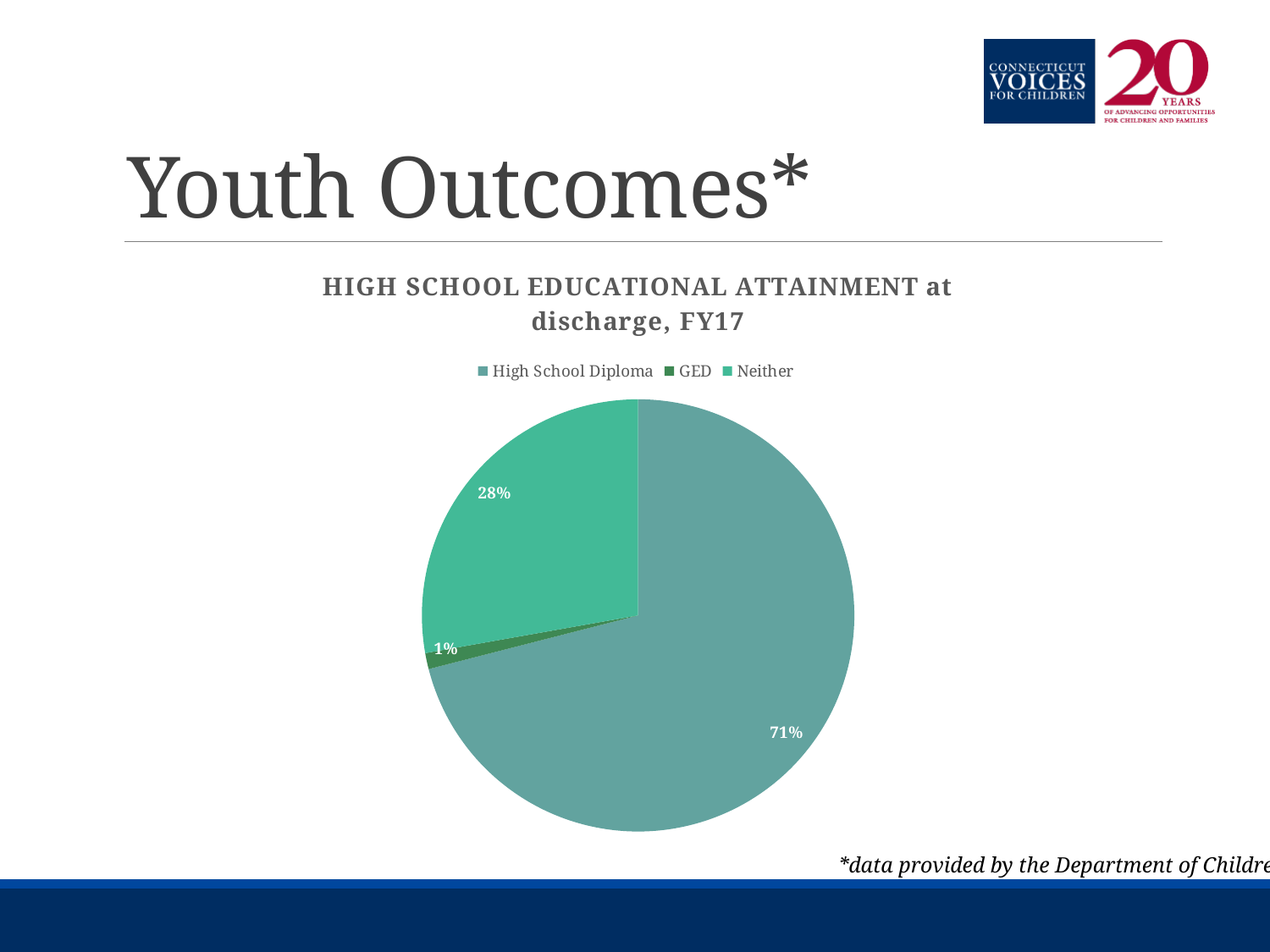
Which category has the smallest slice of the pie? GED Which is larger, the Neither slice or the GED slice? Neither Which category has the largest slice of the pie? High School Diploma What is the title of the chart? HIGH SCHOOL EDUCATIONAL ATTAINMENT at discharge, FY17 What share of the pie is labelled Neither? 28% What are the three legend entries of the chart? High School Diploma, GED, Neither What share of the pie is labelled GED? 1% What is the combined share of the GED and Neither slices? 29% What kind of chart is shown on the slide? Pie chart What share of the pie is labelled High School Diploma? 71% What is the difference in percentage points between the High School Diploma slice and the Neither slice? 43 How many categories does the pie chart show? 3